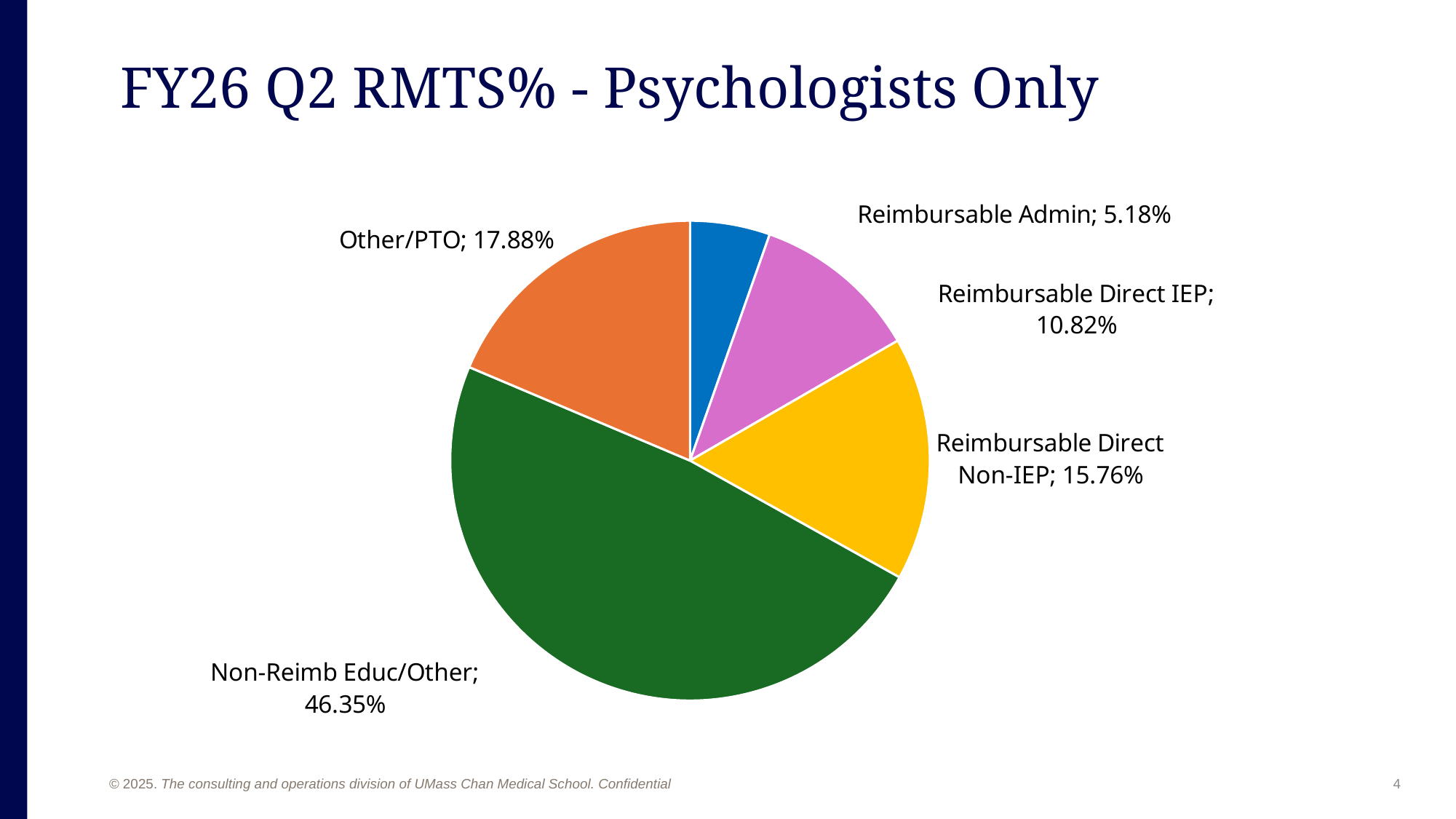
Which category has the smallest slice? Reimbursable Admin What is the value for Reimbursable Direct IEP? 10.82% Which is larger, Reimbursable Direct IEP or Reimbursable Direct Non-IEP? Reimbursable Direct Non-IEP What is the value for Reimbursable Admin? 5.18% What is the value for Non-Reimb Educ/Other? 46.35% What kind of chart is shown on the slide? pie chart How many slices does the pie chart have? 5 What is the difference between Other/PTO and Reimbursable Direct Non-IEP? 2.12% What is the combined share of Reimbursable Admin and Reimbursable Direct IEP? 16.00% Which category has the largest slice? Non-Reimb Educ/Other What is the title of the slide? FY26 Q2 RMTS% - Psychologists Only What is the value for Other/PTO? 17.88%